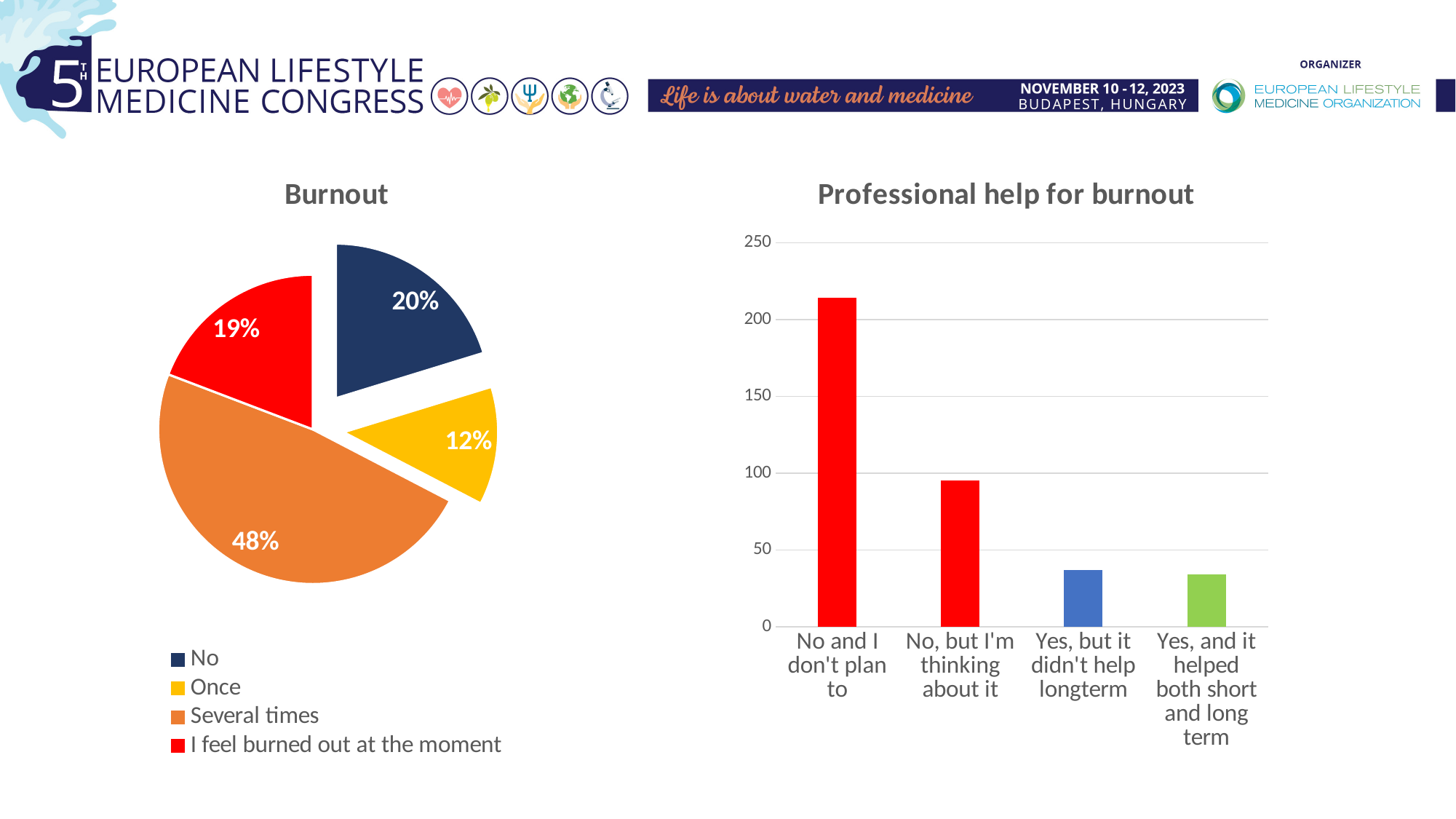
In the Burnout pie chart, what percentage corresponds to "Once"? 12% In the Burnout pie chart, which category has the largest share? Several times In the Burnout pie chart, what share of respondents answered "Several times"? 48% In the "Professional help for burnout" chart, which is larger: "No, but I'm thinking about it" or "Yes, and it helped both short and long term"? No, but I'm thinking about it In the "Professional help for burnout" chart, is the value for "No and I don't plan to" greater or less than 200? greater What type of chart is the "Professional help for burnout" chart? Bar chart In the Burnout pie chart, what is the difference between the "Several times" share and the "No" share? 28% How many categories does the legend of the Burnout pie chart list? 4 In the "Professional help for burnout" chart, is the value for "Yes, but it didn't help longterm" greater or less than 50? less In the Burnout pie chart, which category has the smallest share? Once In the "Professional help for burnout" chart, which category has the highest value? No and I don't plan to In the Burnout pie chart, what percentage corresponds to "I feel burned out at the moment"? 19%